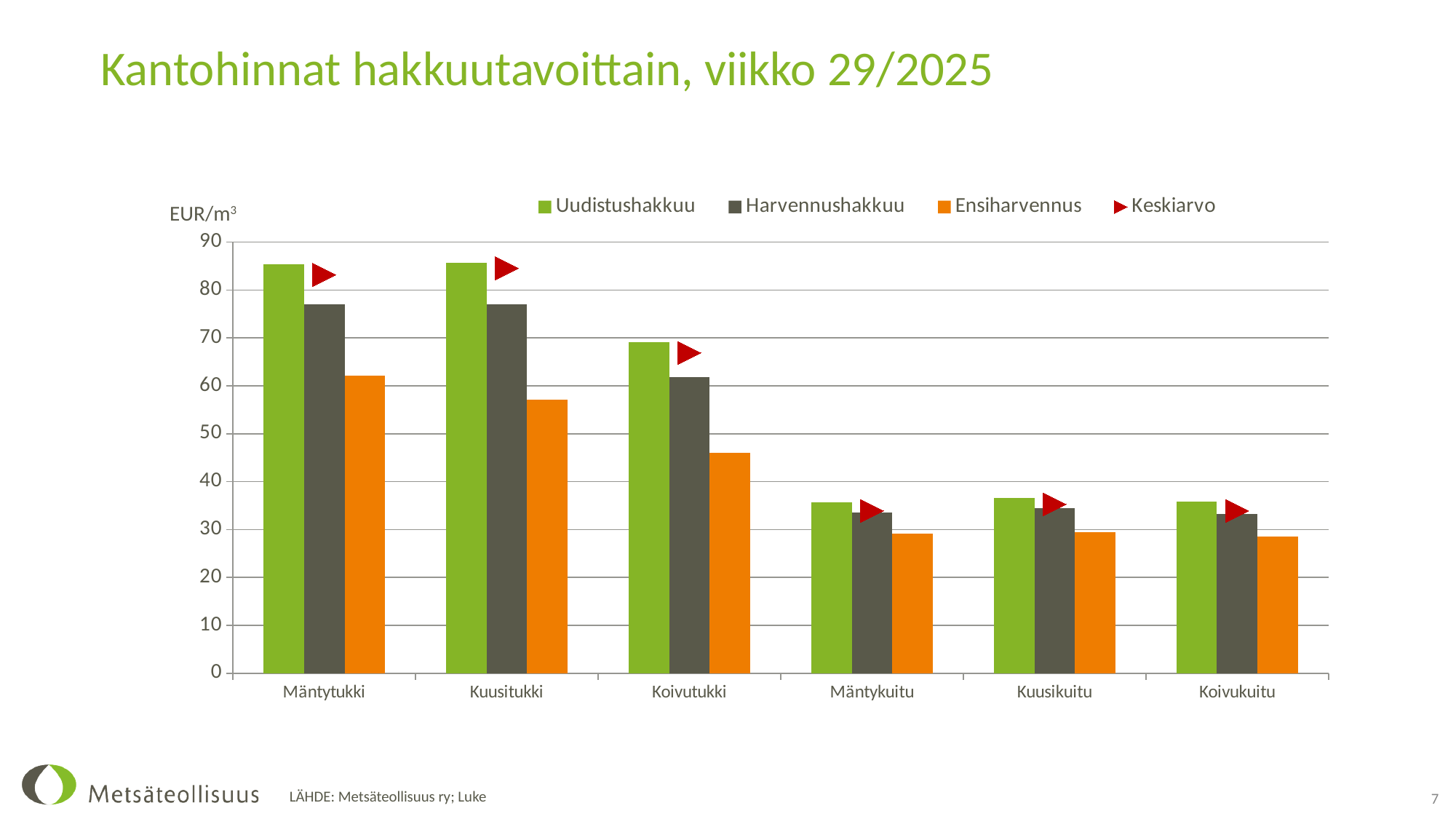
Which category has the highest Ensiharvennus value? Mäntytukki What kind of chart is shown on the slide? bar chart Do the Ensiharvennus values rise or fall across Mäntytukki, Kuusitukki and Koivutukki? fall How many categories are shown on the x axis? 6 Is the Uudistushakkuu value for Mäntytukki greater or less than 80? greater Is the Ensiharvennus value for Koivutukki greater or less than 50? less Is the Harvennushakkuu value for Koivutukki greater or less than 60? greater How many series does the legend list? 4 Which is larger for Koivutukki: the Uudistushakkuu value or the Ensiharvennus value? Uudistushakkuu What unit is shown on the y axis? EUR/m³